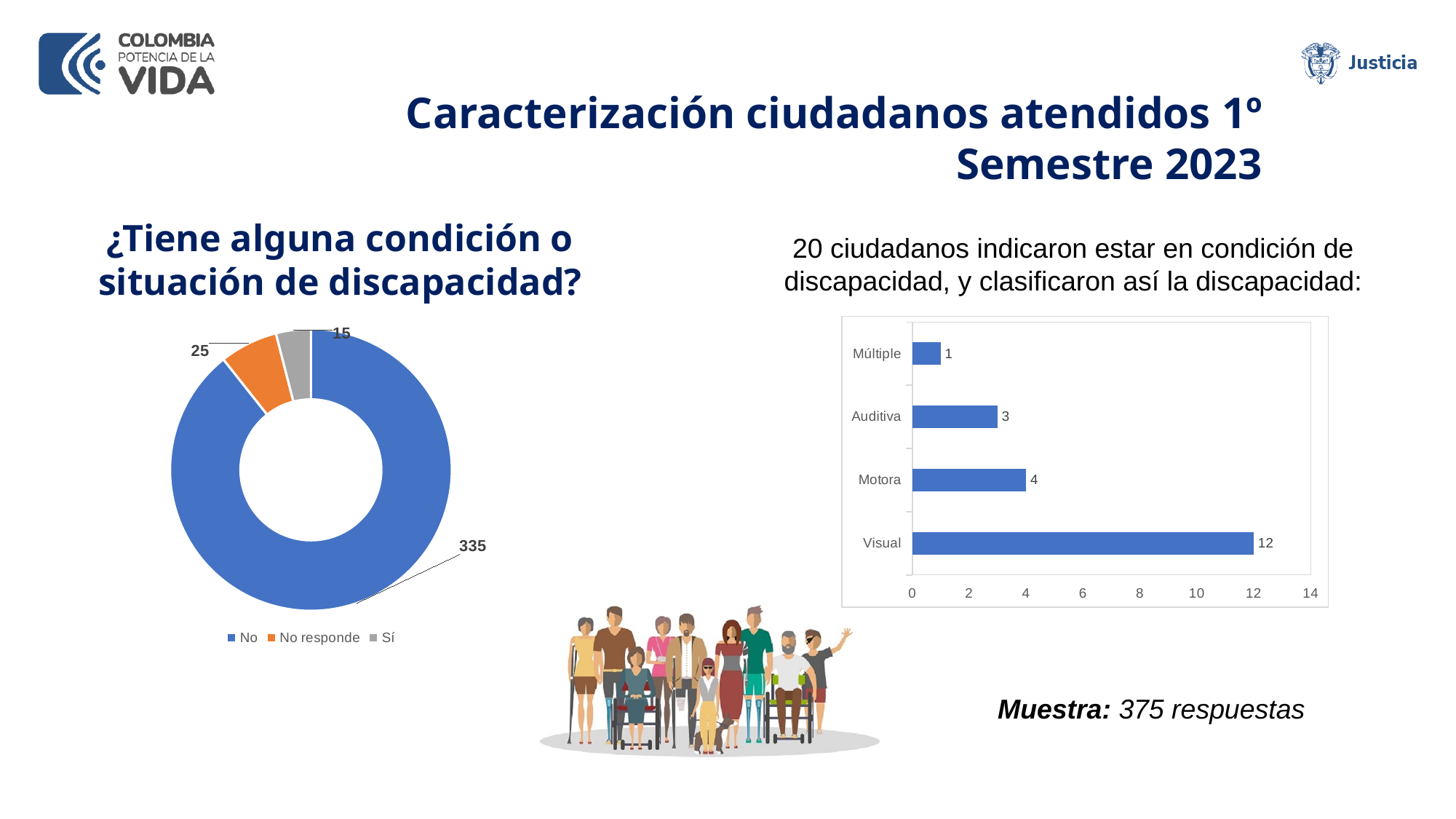
In the bar chart on the right, which category has the lowest value? Múltiple In the donut chart on the left, what share of the total do the "Sí" responses represent? 4% In the donut chart on the left, what is the difference between the values for "No responde" and "Sí"? 10 What kind of chart is shown on the right side of the slide? Bar chart In the donut chart on the left, what is the value for "No"? 335 In the donut chart on the left, which category has the smallest value? Sí In the bar chart on the right, what is the value for "Visual"? 12 In the donut chart on the left, what is the value for "No responde"? 25 In the donut chart on the left, how many categories does the legend list? 3 In the donut chart on the left, what is the value for "Sí"? 15 In the bar chart on the right, what is the difference between the values for "Visual" and "Motora"? 8 In the bar chart on the right, which category has the highest value? Visual